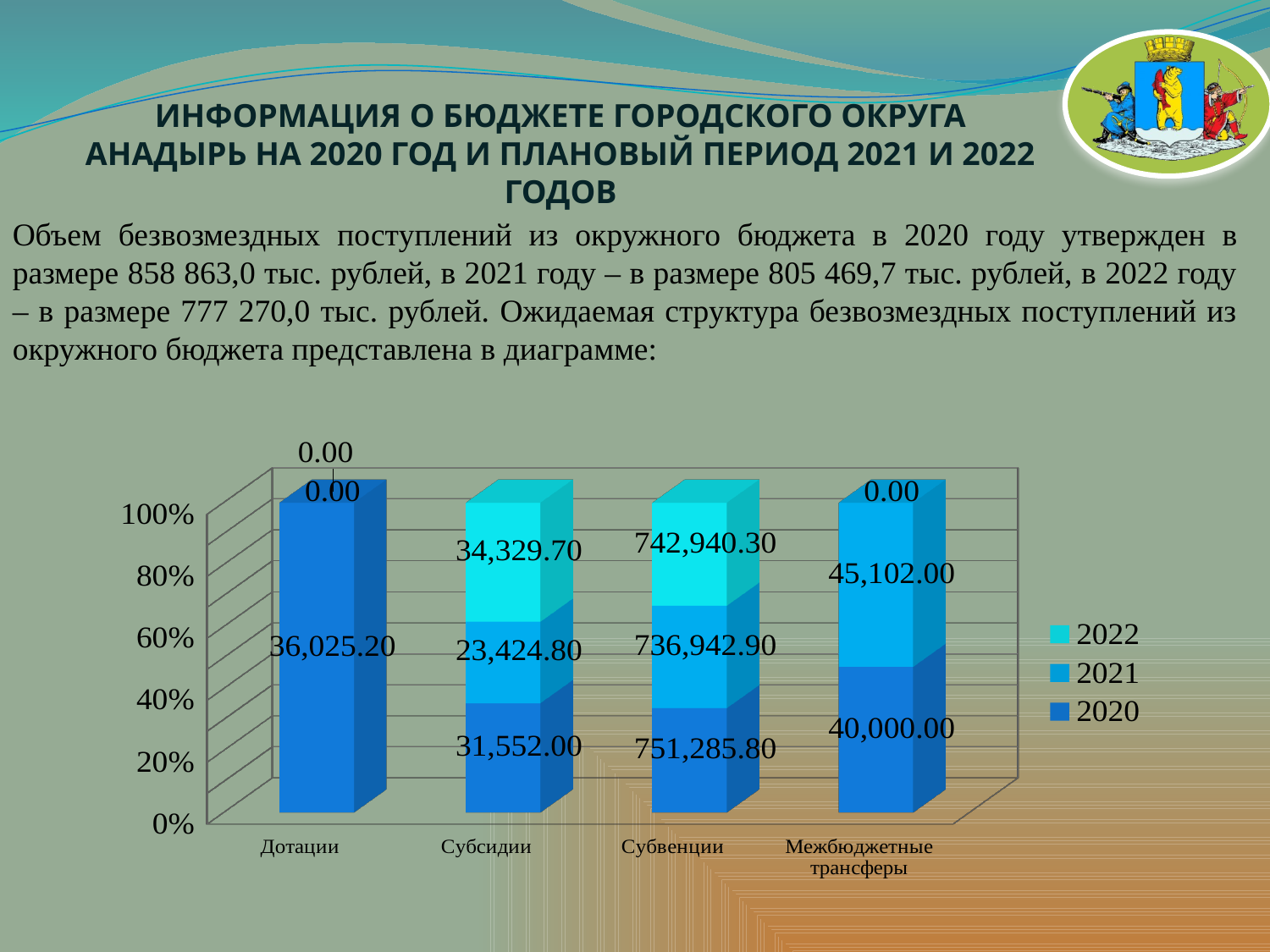
Which category has the highest value in the 2020 series? Субвенции What kind of chart is shown on the slide? Stacked bar chart What is the value for Дотации in the 2020 series? 36,025.20 What is the difference between the 2021 and 2020 values for Межбюджетные трансферы? 5,102.00 Which category has the lowest value in the 2022 series? Дотации and Межбюджетные трансферы (both 0.00) How many series does the legend list? 3 What is the difference between the 2020 and 2021 values for Субвенции? 14,342.90 What is the value for Межбюджетные трансферы in the 2021 series? 45,102.00 What is the value for Субвенции in the 2020 series? 751,285.80 How many categories are shown on the x axis? 4 Which is larger for Субсидии: the 2020 value or the 2021 value? 2020 What is the value for Субсидии in the 2022 series? 34,329.70